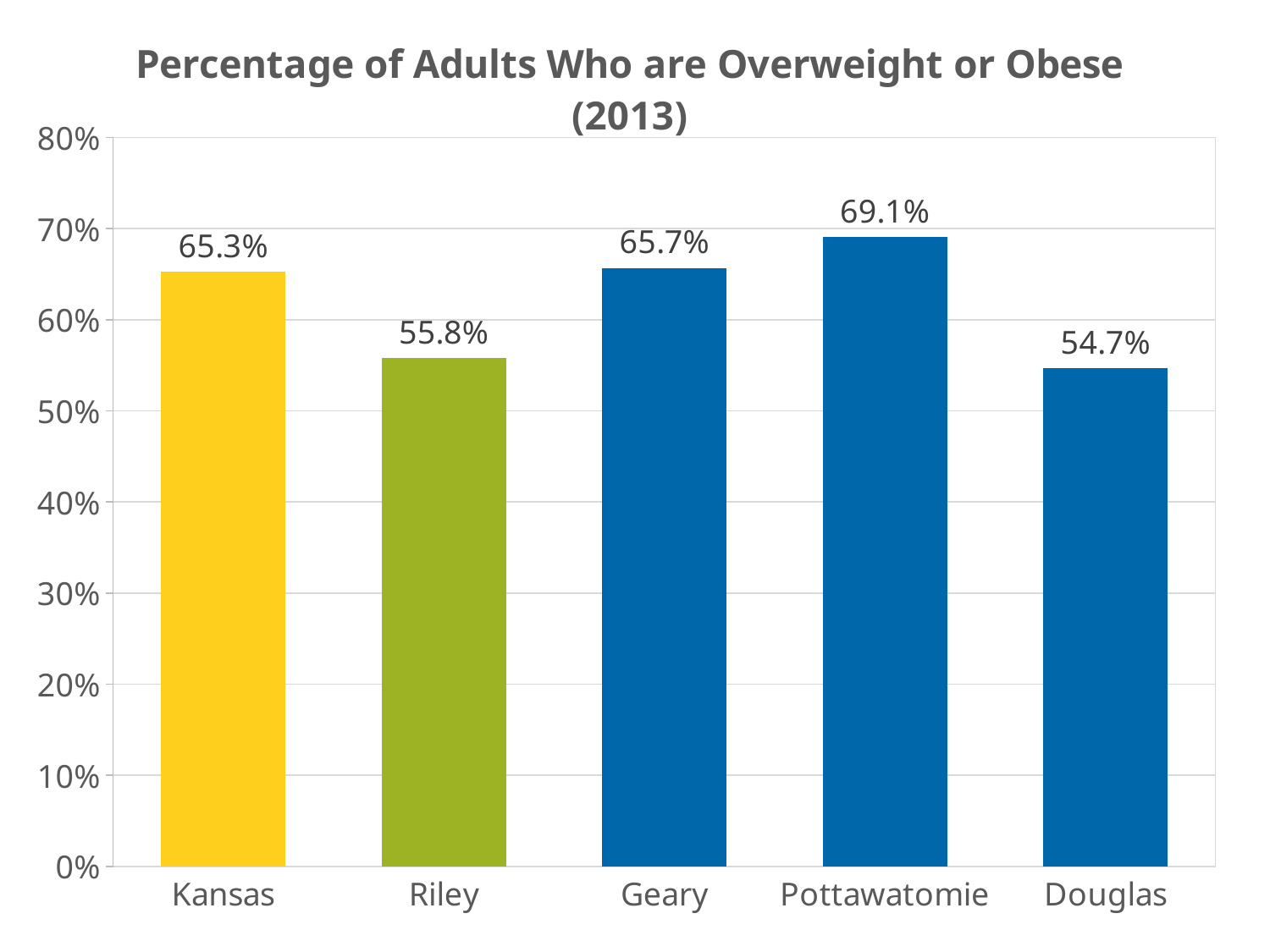
What is the title of the chart? Percentage of Adults Who are Overweight or Obese (2013) What is the difference between the values for Geary and Kansas? 0.4% What is the difference between the values for Pottawatomie and Douglas? 14.4% What kind of chart is shown on the slide? Bar chart Which has a larger value, Riley or Geary? Geary Which category has the lowest percentage? Douglas What is the value shown for Riley? 55.8% Is the value for Douglas greater or less than 60%? less Which category has the highest percentage? Pottawatomie How many categories are shown on the chart? 5 What is the value shown for Pottawatomie? 69.1% What is the percentage of adults who are overweight or obese in Kansas? 65.3%